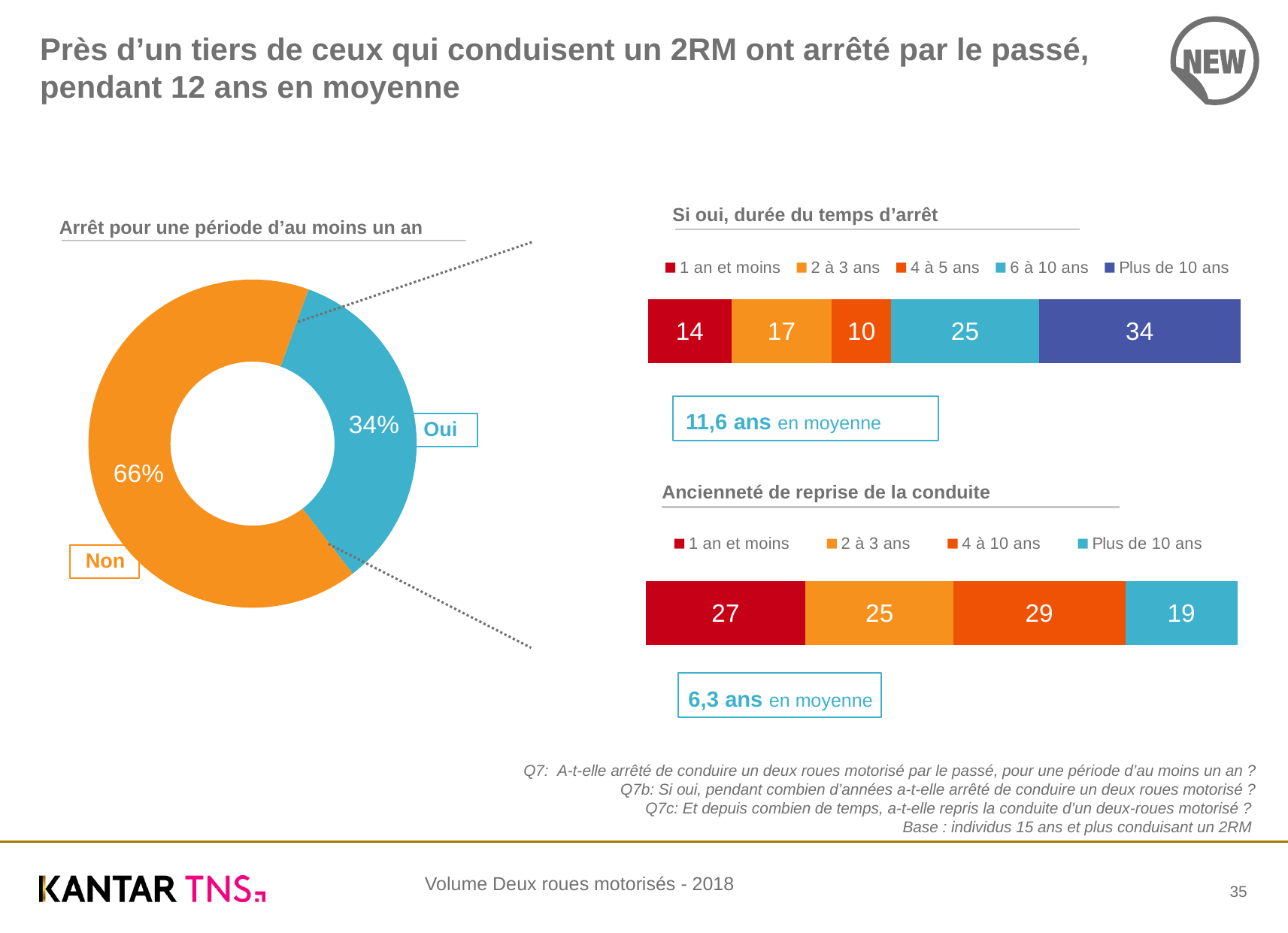
In the chart 'Ancienneté de reprise de la conduite', which category has the highest value? 4 à 10 ans In the chart 'Si oui, durée du temps d'arrêt', which category has the lowest value? 4 à 5 ans What kind of chart is 'Arrêt pour une période d'au moins un an'? Donut (pie) chart In the chart 'Si oui, durée du temps d'arrêt', what is the value for '6 à 10 ans'? 25 In the chart 'Si oui, durée du temps d'arrêt', how many categories does the legend list? 5 In the chart 'Arrêt pour une période d'au moins un an', what share of respondents answered 'Oui'? 34% In the chart 'Ancienneté de reprise de la conduite', what is the value for '2 à 3 ans'? 25 In the chart 'Si oui, durée du temps d'arrêt', which category has the highest value? Plus de 10 ans In the chart 'Si oui, durée du temps d'arrêt', what is the difference between 'Plus de 10 ans' and '1 an et moins'? 20 In the chart 'Ancienneté de reprise de la conduite', which is larger: '1 an et moins' or 'Plus de 10 ans'? 1 an et moins In the chart 'Ancienneté de reprise de la conduite', what is the total of the stacked bar? 100 In the chart 'Arrêt pour une période d'au moins un an', what share of respondents answered 'Non'? 66%